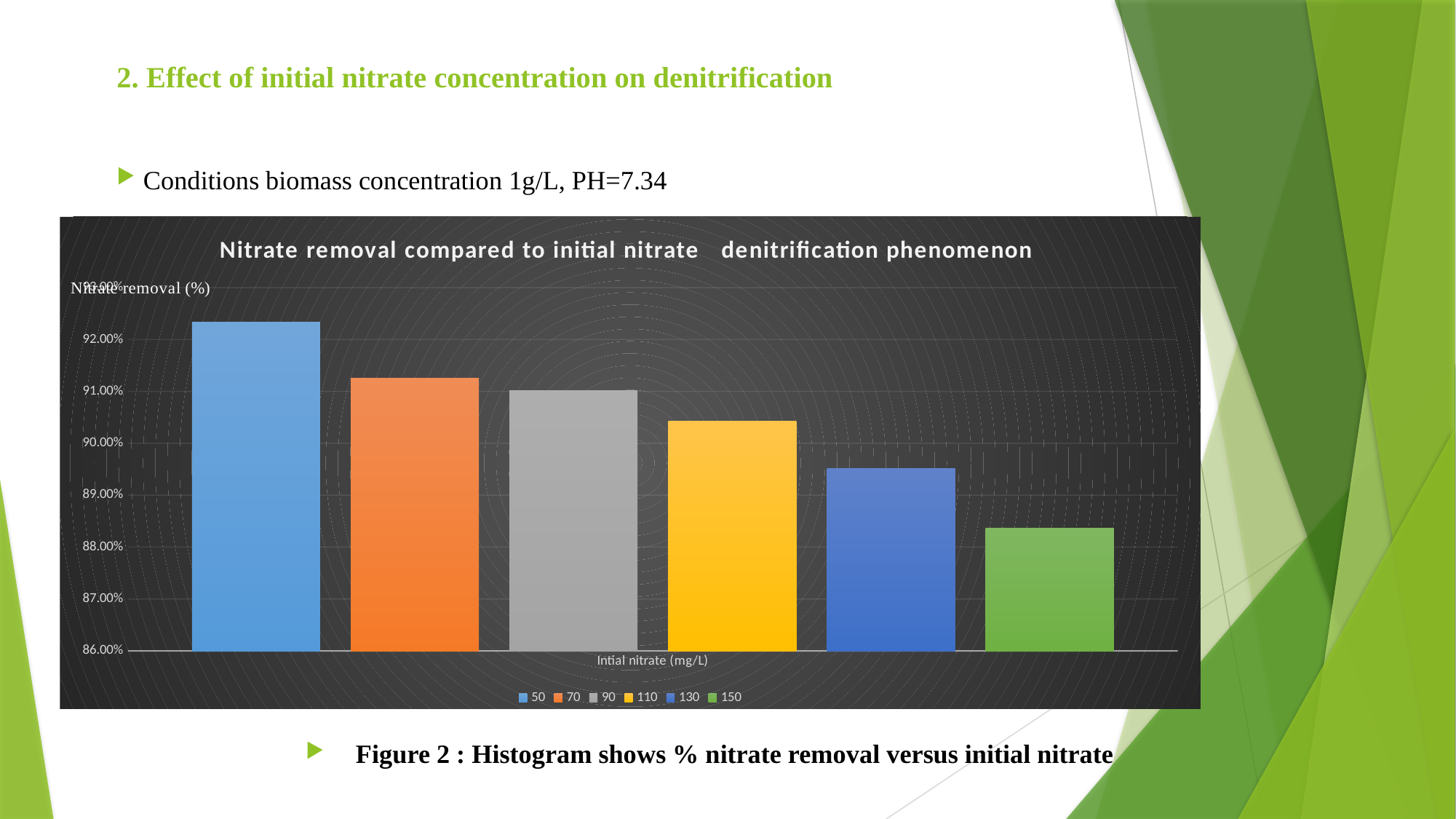
Which has a higher nitrate removal, initial nitrate 50 or 150? 50 Is the nitrate removal for initial nitrate 50 greater or less than 91.00%? greater Which has a higher nitrate removal, initial nitrate 70 or 130? 70 What is the label on the x axis of the chart? Intial nitrate (mg/L) Is the nitrate removal for initial nitrate 150 greater or less than 89.00%? less Which initial nitrate concentration has the highest nitrate removal? 50 Do the bar values rise or fall as the initial nitrate concentration increases from 50 to 150? fall How many bars are plotted in the chart? 6 How many entries does the chart legend list? 6 What kind of chart is shown on the slide? bar chart Which initial nitrate concentration has the lowest nitrate removal? 150 Is the nitrate removal for initial nitrate 130 greater or less than 90.00%? less